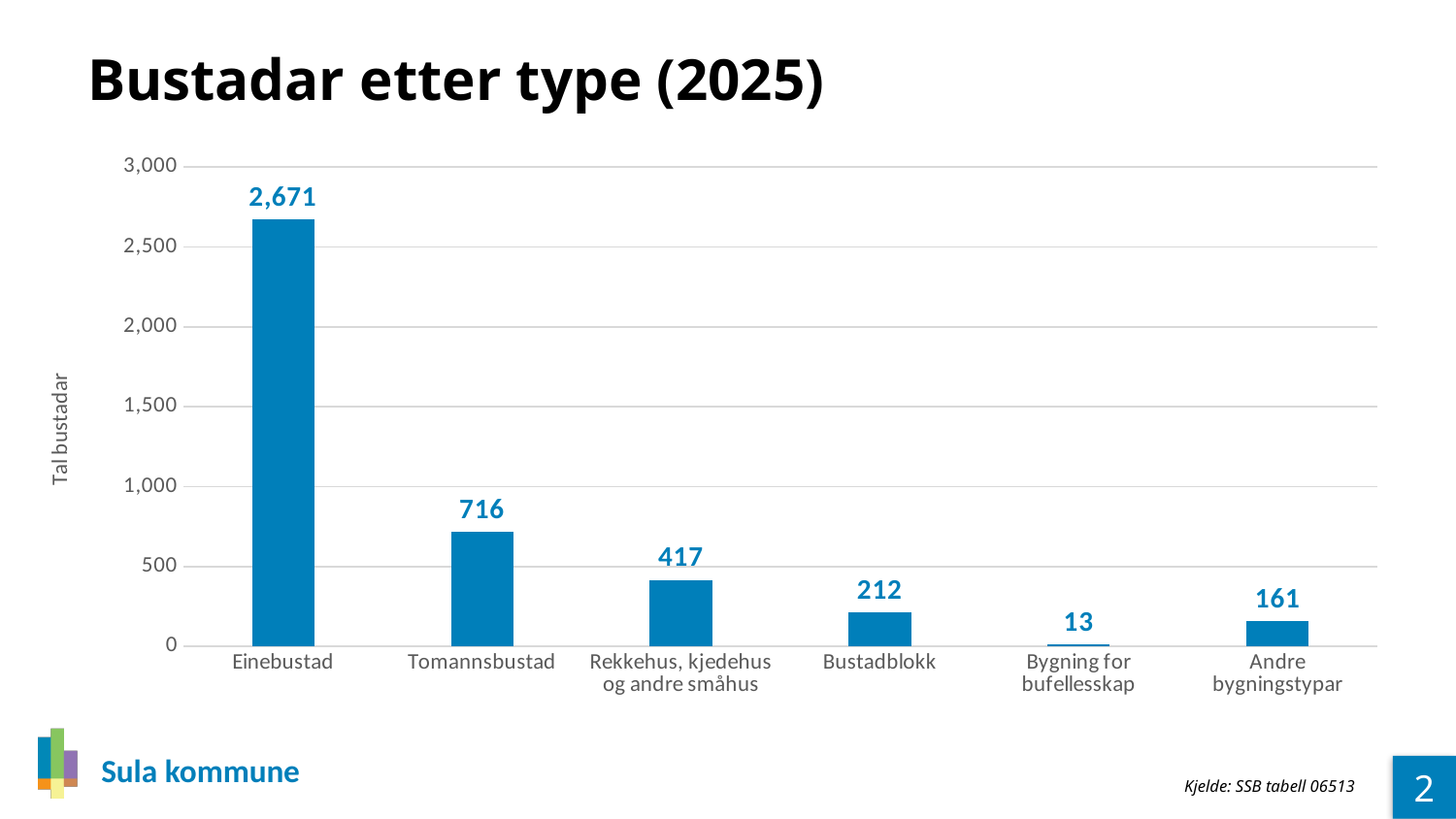
Which category has the highest value? Einebustad Which is larger, the value for Bustadblokk or the value for Andre bygningstypar? Bustadblokk What is the title of the chart? Bustadar etter type (2025) What kind of chart is shown on the slide? Bar chart What is the difference between the values for Einebustad and Tomannsbustad? 1,955 What is the value for Tomannsbustad? 716 What is the difference between the values for Rekkehus, kjedehus og andre småhus and Bustadblokk? 205 What is the value for Bygning for bufellesskap? 13 What is the value for Bustadblokk? 212 What is the value for Einebustad? 2,671 How many categories are shown on the x axis? 6 Which category has the lowest value? Bygning for bufellesskap